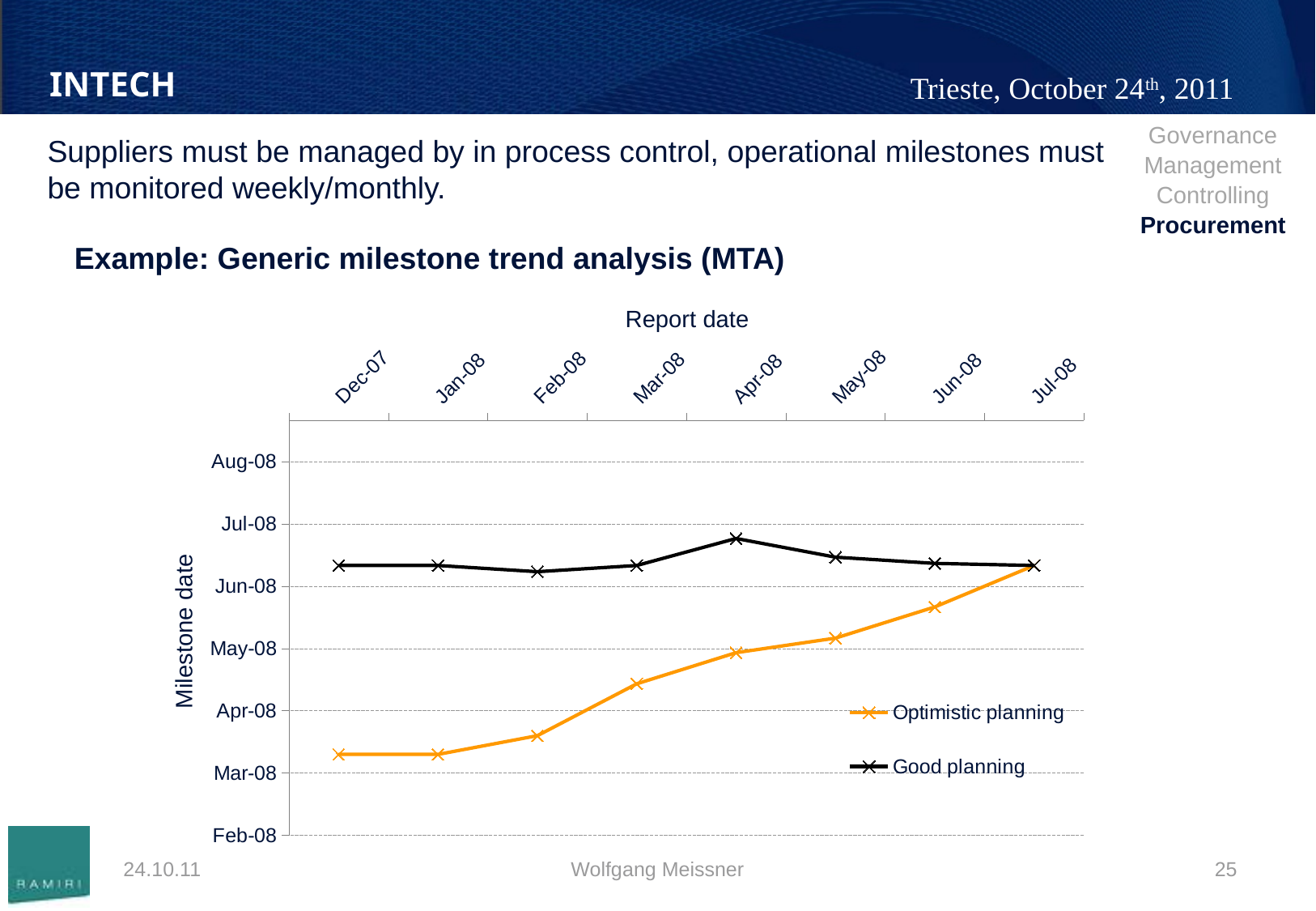
Is the Optimistic planning milestone date at the Mar-08 report date earlier or later than Apr-08? later Does the Optimistic planning milestone date rise or fall across the report dates from Dec-07 to Jul-08? rise Is the Good planning milestone date at the Apr-08 report date earlier or later than Jun-08? later At which report date does the Optimistic planning series reach its latest milestone date? Jul-08 Is the Optimistic planning milestone date at the Dec-07 report date earlier or later than Apr-08? earlier At which report date does the Good planning series reach its latest milestone date? Apr-08 At the Dec-07 report date, which series shows the later milestone date, Optimistic planning or Good planning? Good planning Which series is plotted in orange? Optimistic planning How many report dates are plotted along the x axis? 8 What is the title of the vertical axis? Milestone date What kind of chart is shown on the slide? line chart How many series does the legend list? 2